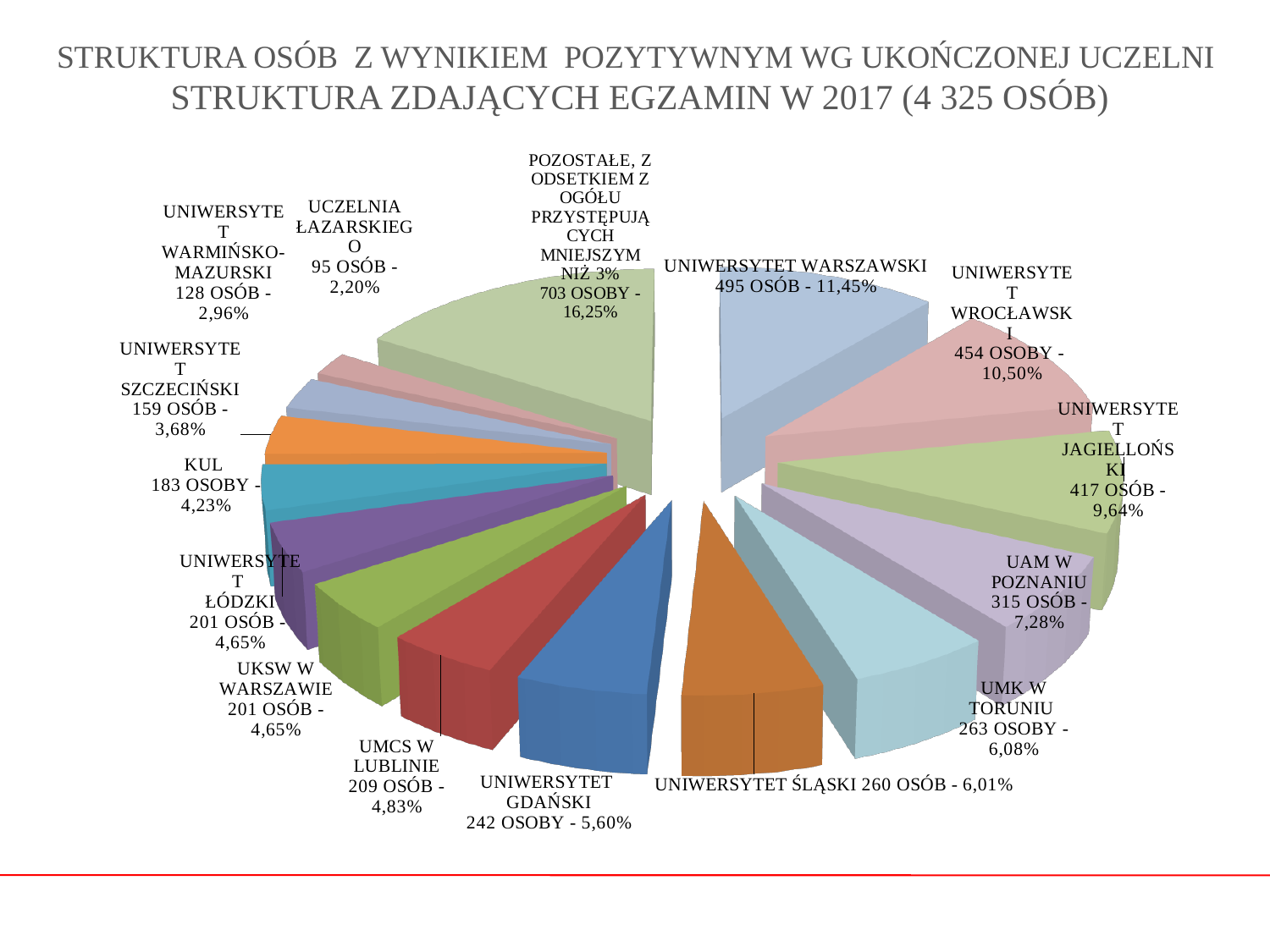
What share of the pie does the 'Pozostałe' (remaining) slice have? 16,25% What share of the pie does Uniwersytet Jagielloński have? 9,64% Which slice represents the largest number of people? POZOSTAŁE (703 OSOBY) What is the difference in number of people between Uniwersytet Warszawski and Uniwersytet Wrocławski? 41 How many slices does the pie chart have? 15 Which named university has the smallest slice? UCZELNIA ŁAZARSKIEGO What percentage share does Uniwersytet Szczeciński have? 3,68% Which has more people, UMCS w Lublinie or KUL? UMCS W LUBLINIE What kind of chart is shown on the slide? pie chart According to the title, how many people took the exam in 2017? 4 325 OSÓB How many people from Uniwersytet Warszawski are shown in the pie chart? 495 OSÓB How many people are in the UMK w Toruniu slice? 263 OSOBY